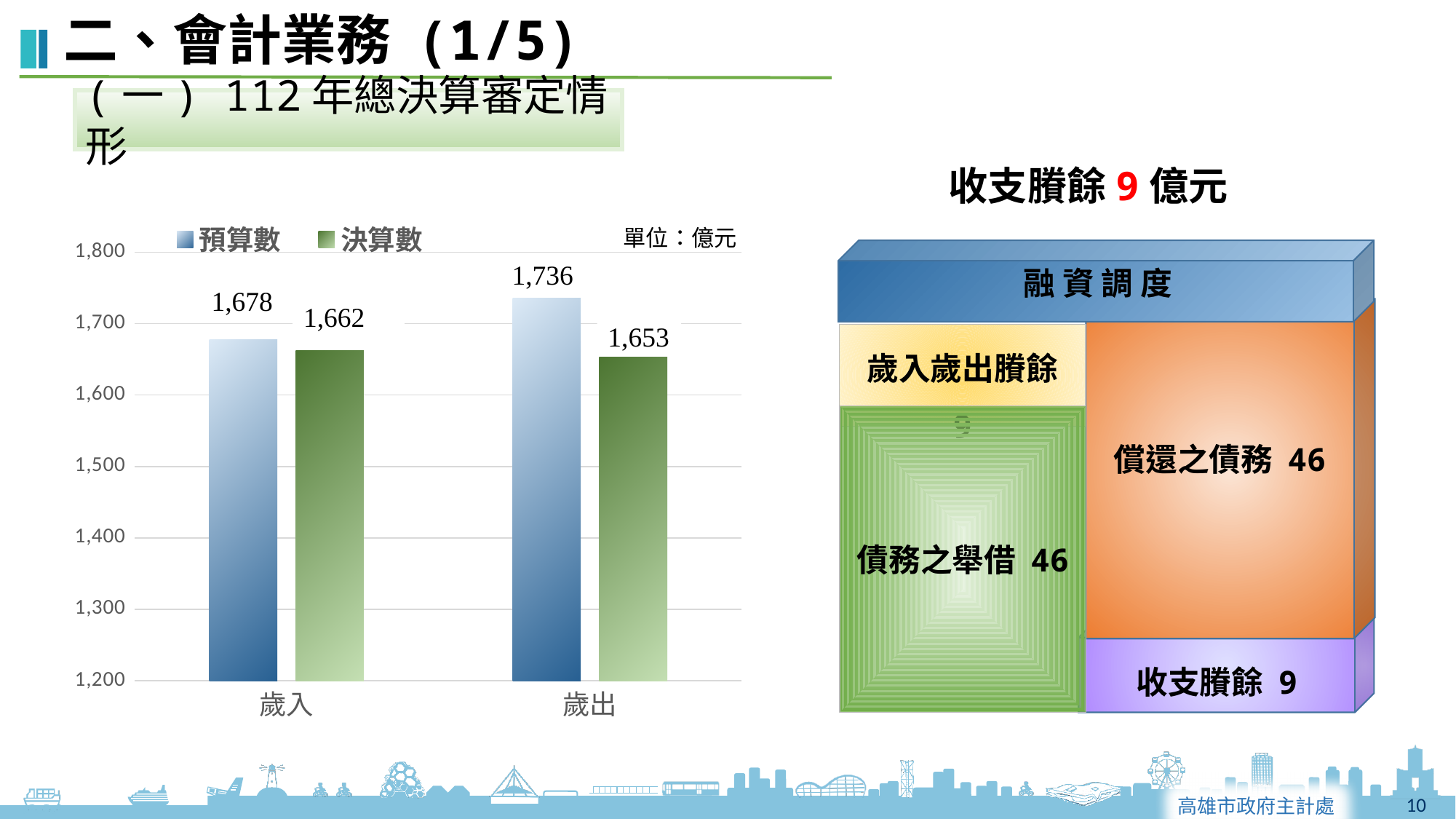
What kind of chart is shown on the left of the slide? bar chart Which bar in the bar chart has the lowest value? 歲出 決算數 What is the 預算數 value for 歲入 in the bar chart? 1,678 How many series does the legend of the bar chart list? 2 What unit is stated for the values in the bar chart? 億元 What is the 決算數 value for 歲出 in the bar chart? 1,653 What is the 預算數 value for 歲出 in the bar chart? 1,736 What is the 決算數 value for 歲入 in the bar chart? 1,662 In the bar chart, which is larger: the 決算數 for 歲入 or the 決算數 for 歲出? 決算數 for 歲入 In the bar chart, what is the difference between the 預算數 and 決算數 values for 歲出? 83 Which bar in the bar chart has the highest value? 歲出 預算數 In the bar chart, what is the difference between the 預算數 and 決算數 values for 歲入? 16